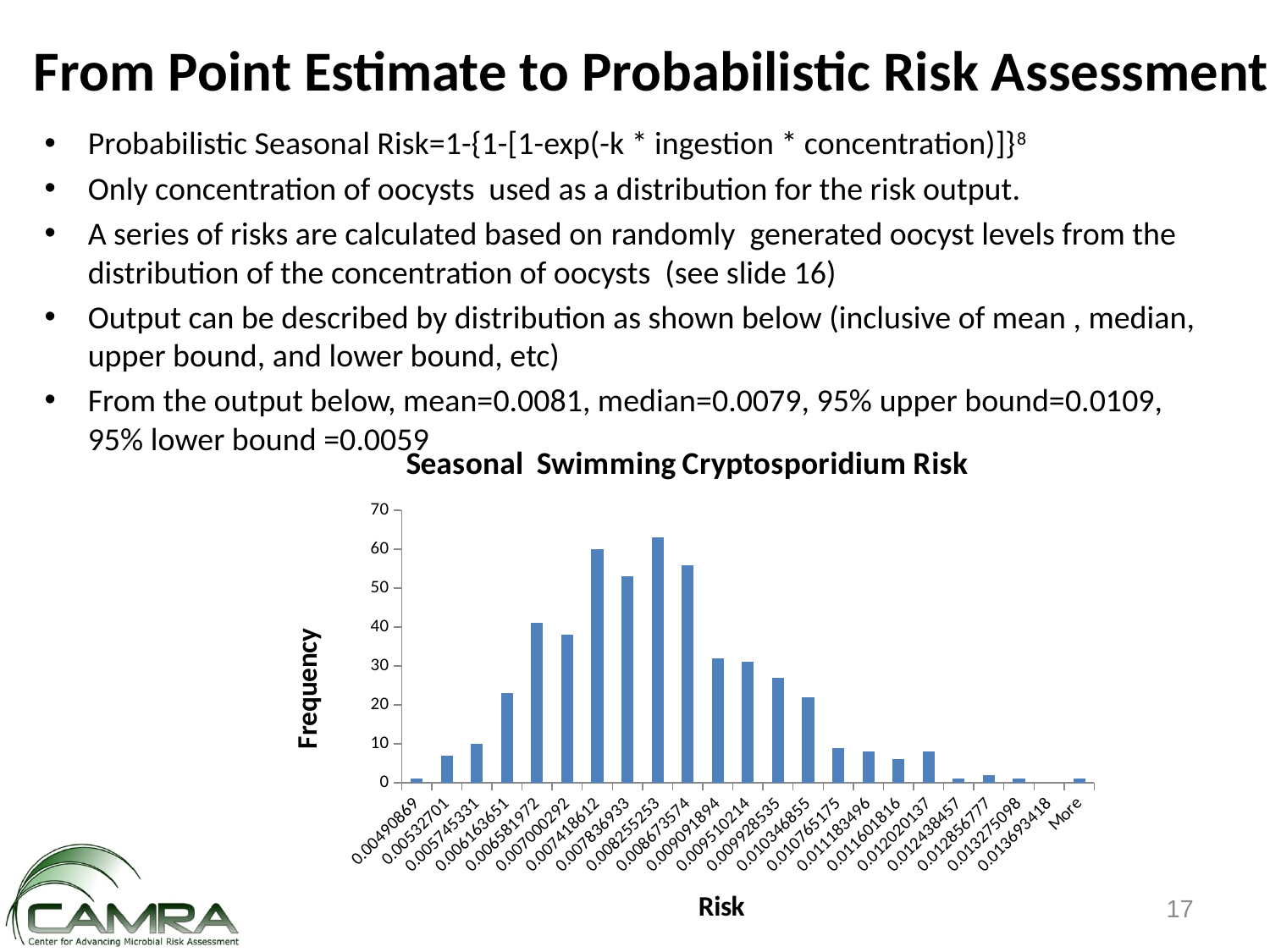
What is the title of the chart? Seasonal Swimming Cryptosporidium Risk Is the frequency for the 0.006163651 bin greater or less than 30? less Which bin has the higher frequency, 0.006581972 or 0.009510214? 0.006581972 Which risk bin has the highest frequency? 0.008255253 Is the frequency for the 0.007000292 bin greater or less than 30? greater Which bin has the higher frequency, 0.007418612 or 0.007836933? 0.007418612 Do the frequencies generally rise or fall from the 0.00490869 bin to the 0.008255253 bin? rise Is the frequency for the 0.007418612 bin greater or less than 50? greater What is the label of the vertical axis of the chart? Frequency What kind of chart is shown on the slide? bar chart